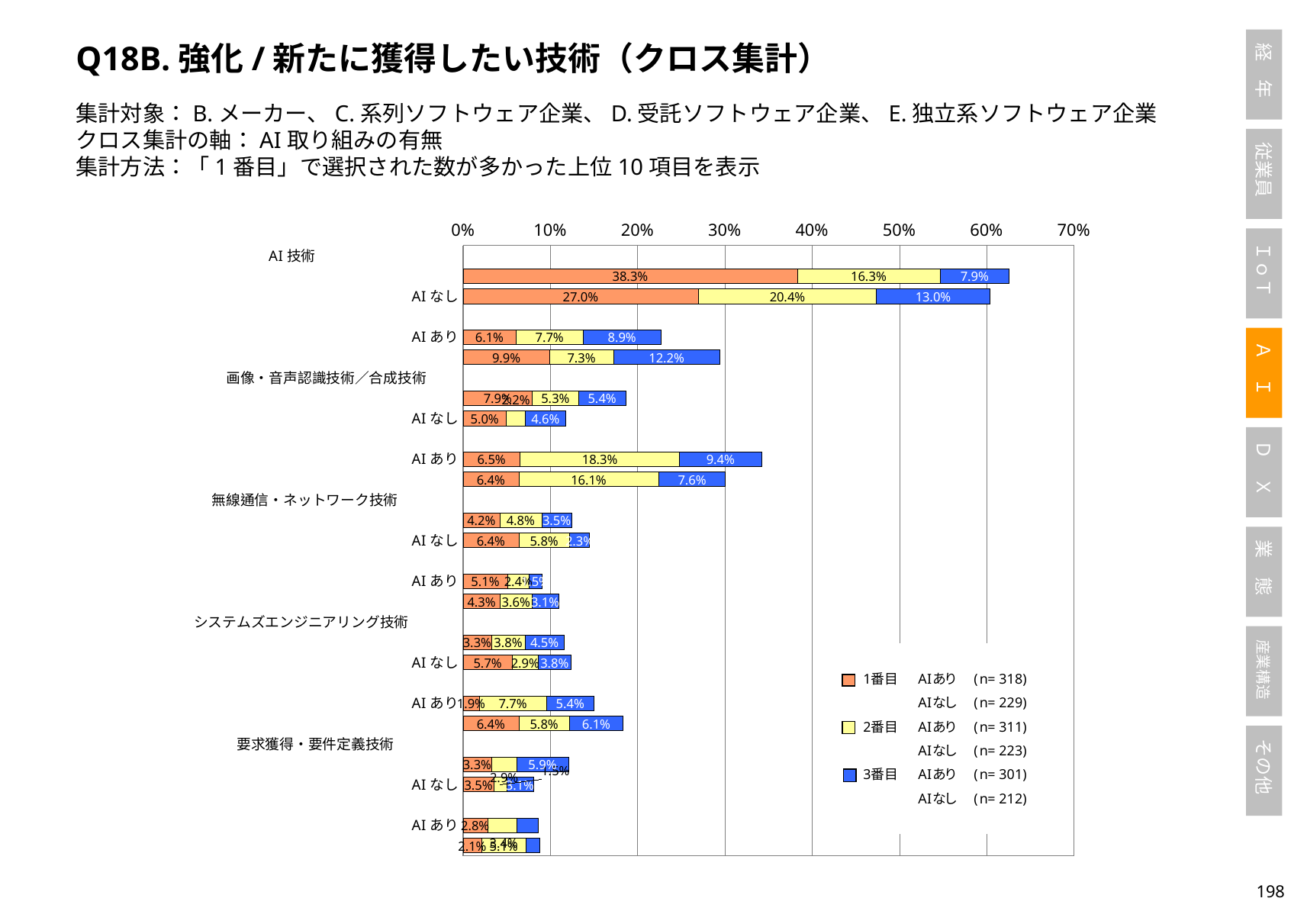
Which colour represents 1番目 in the legend? Orange What is the 2番目 value printed on the topmost bar of the chart? 16.3% What is the 3番目 value printed on the second bar from the top (labelled AI なし under AI 技術)? 13.0% Which has the larger 2番目 value: the topmost bar or the second bar from the top? The second bar from the top (20.4%) What is the total of the three segments of the topmost bar (38.3%, 16.3%, 7.9%)? 62.5% What is the 1番目 value printed on the topmost bar of the chart? 38.3% According to the legend, what is the n for 1番目 AIあり? n= 318 How many series does the legend list? 3 What is the highest value printed on the x axis? 70% What is the difference between the 1番目 value of the topmost bar (38.3%) and the 1番目 value of the second bar (27.0%)? 11.3 percentage points Is the total length of the topmost bar greater or less than 60%? greater What kind of chart is shown on the slide? Stacked horizontal bar chart